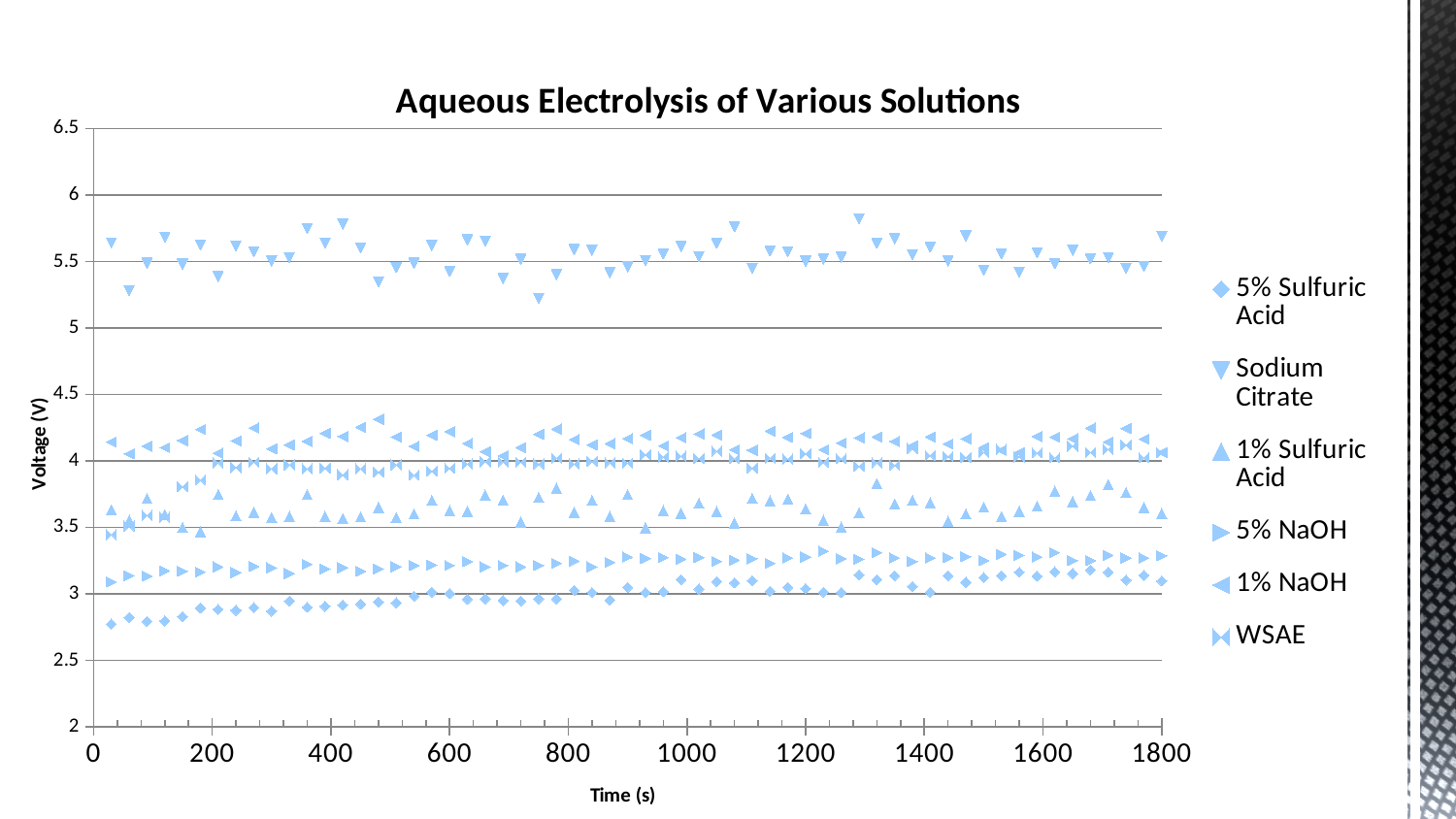
Do the voltage values for 5% Sulfuric Acid rise or fall as time increases from 0 to 1800 s? rise How many series does the legend list? 6 Are the voltage values for 5% NaOH greater or less than 3.5? less Which series has the lowest voltage values throughout the chart? 5% Sulfuric Acid What kind of chart is shown on the slide? scatter chart What is the label on the vertical axis of the chart? Voltage (V) Which series has higher voltage values, 1% NaOH or 5% NaOH? 1% NaOH Are the voltage values for 1% NaOH greater or less than 3.5? greater Which series has higher voltage values, WSAE or 1% Sulfuric Acid? WSAE What is the title of the chart? Aqueous Electrolysis of Various Solutions Which series has the highest voltage values throughout the chart? Sodium Citrate Are the voltage values for Sodium Citrate greater or less than 5? greater